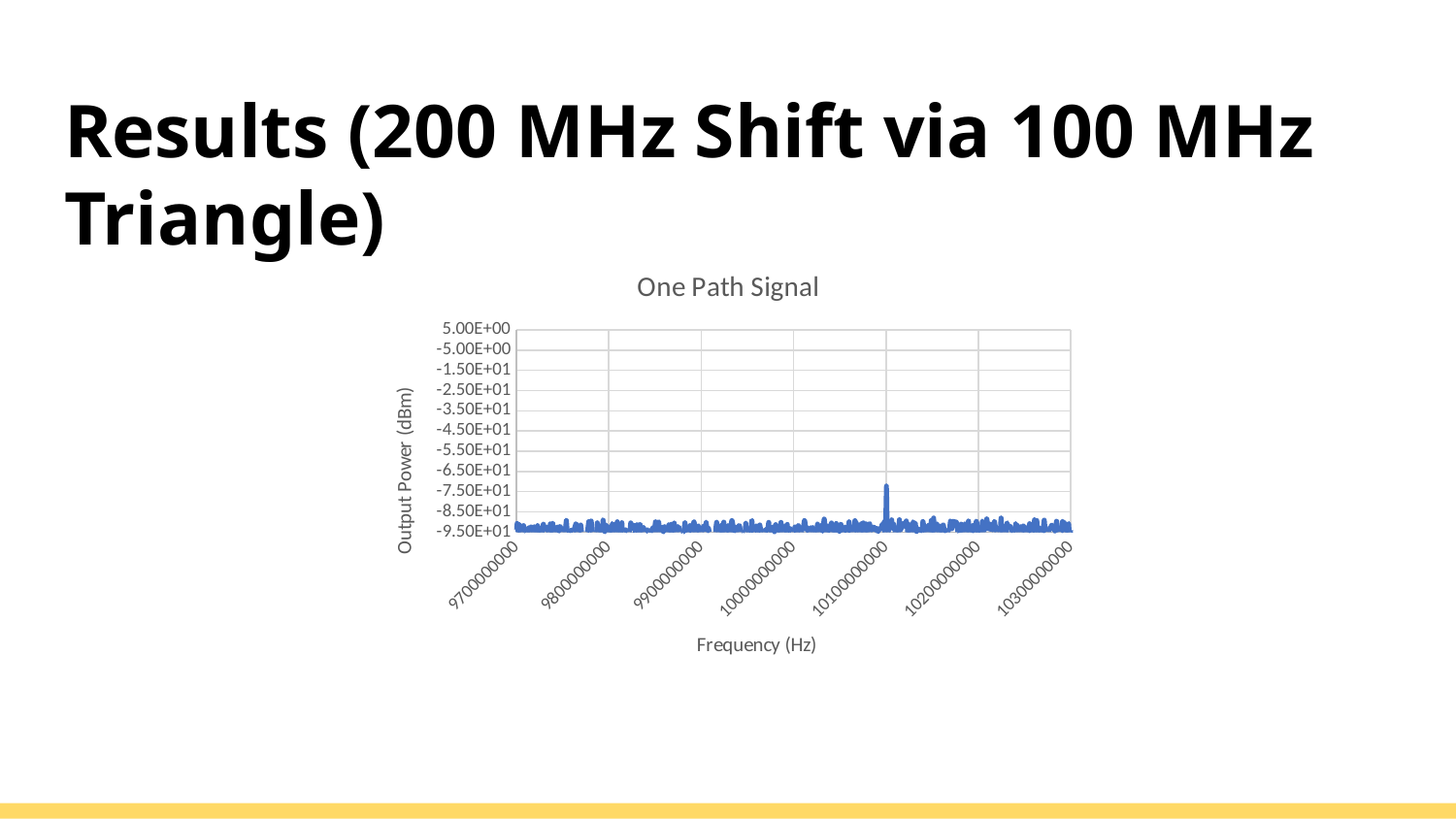
Is the value at 9800000000 Hz greater or less than -8.50E+01? less How many labelled tick marks are on the x axis? 7 What kind of chart is shown on the slide? line chart What is the label of the x axis? Frequency (Hz) Is the peak value of the signal greater or less than -6.50E+01? less What is the title of the chart? One Path Signal What is the lowest value shown on the y axis? -9.50E+01 Near which labelled x-axis tick does the signal reach its highest value? 10100000000 What is the first x-axis tick label on the chart? 9700000000 Apart from the single spike, does the signal rise, fall, or stay roughly flat across the frequency range? stay roughly flat What is the highest value shown on the y axis? 5.00E+00 Is the peak value of the signal greater or less than -8.50E+01? greater